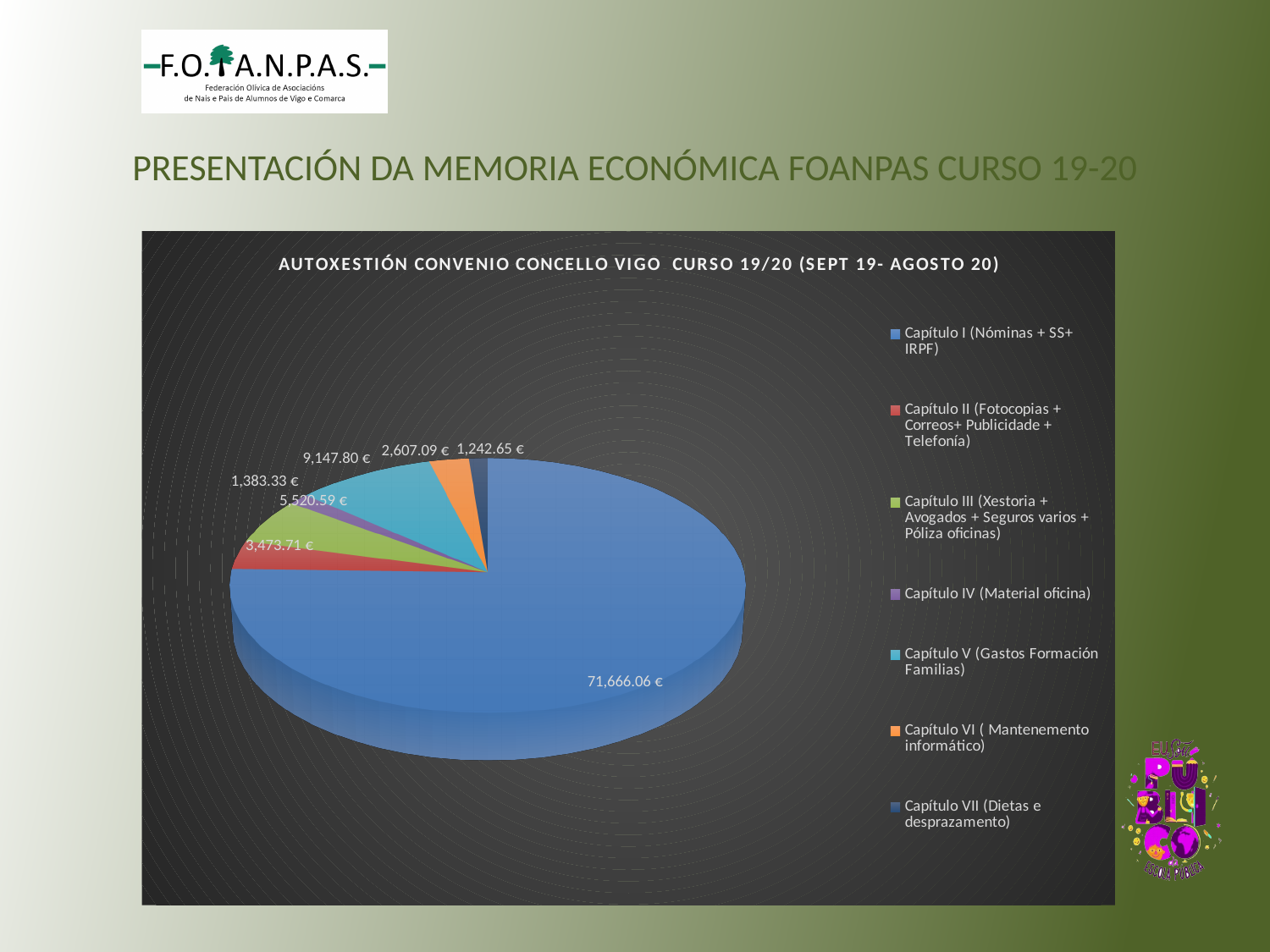
What is the value for Capítulo V (Gastos Formación Familias)? 9,147.80 € Which category has the smallest slice of the pie? Capítulo VII (Dietas e desprazamento) What is the value for Capítulo I (Nóminas + SS+ IRPF)? 71,666.06 € How many categories does the legend list? 7 What is the value for Capítulo III (Xestoria + Avogados + Seguros varios + Póliza oficinas)? 5,520.59 € What type of chart is shown on the slide? Pie chart What is the value for Capítulo VII (Dietas e desprazamento)? 1,242.65 € Which is larger, the value for Capítulo II (Fotocopias + Correos+ Publicidade + Telefonía) or Capítulo VI (Mantenemento informático)? Capítulo II (Fotocopias + Correos+ Publicidade + Telefonía) What is the difference between the values for Capítulo V (Gastos Formación Familias) and Capítulo III (Xestoria + Avogados + Seguros varios + Póliza oficinas)? 3,627.21 € What colour is the slice for Capítulo VI (Mantenemento informático)? Orange Which category has the largest slice of the pie? Capítulo I (Nóminas + SS+ IRPF) What is the title of the chart? AUTOXESTIÓN CONVENIO CONCELLO VIGO CURSO 19/20 (SEPT 19- AGOSTO 20)